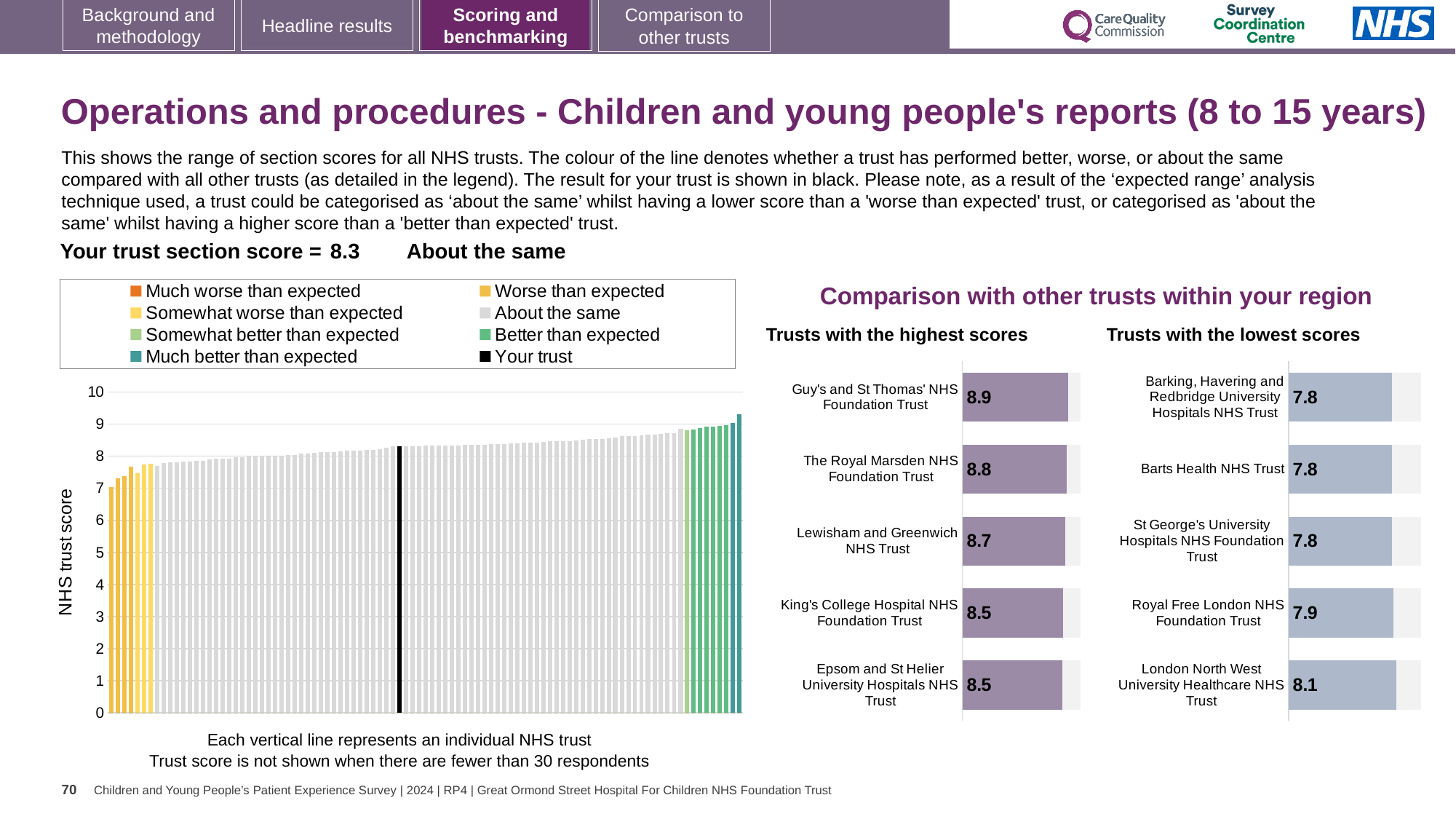
How many entries does the legend of the NHS trust score chart on the left list? 8 What kind of chart is the NHS trust score chart on the left of the slide? Bar chart In the 'Trusts with the lowest scores' chart, what is the score for Royal Free London NHS Foundation Trust? 7.9 In the 'Trusts with the highest scores' chart, what is the score for Lewisham and Greenwich NHS Trust? 8.7 In the 'Trusts with the lowest scores' chart, which trust has the highest score? London North West University Healthcare NHS Trust In the 'Trusts with the lowest scores' chart, what is the score for London North West University Healthcare NHS Trust? 8.1 In the 'Trusts with the highest scores' chart, what is the score for Guy's and St Thomas' NHS Foundation Trust? 8.9 In the 'Trusts with the highest scores' chart, what is the difference between the scores of Guy's and St Thomas' NHS Foundation Trust and Lewisham and Greenwich NHS Trust? 0.2 How many trusts are shown in the 'Trusts with the lowest scores' chart? 5 In the 'Trusts with the highest scores' chart, which trust has the highest score? Guy's and St Thomas' NHS Foundation Trust In the 'Trusts with the highest scores' chart, which has the higher score: The Royal Marsden NHS Foundation Trust or King's College Hospital NHS Foundation Trust? The Royal Marsden NHS Foundation Trust In the 'Trusts with the lowest scores' chart, what is the difference between the scores of London North West University Healthcare NHS Trust and Barts Health NHS Trust? 0.3